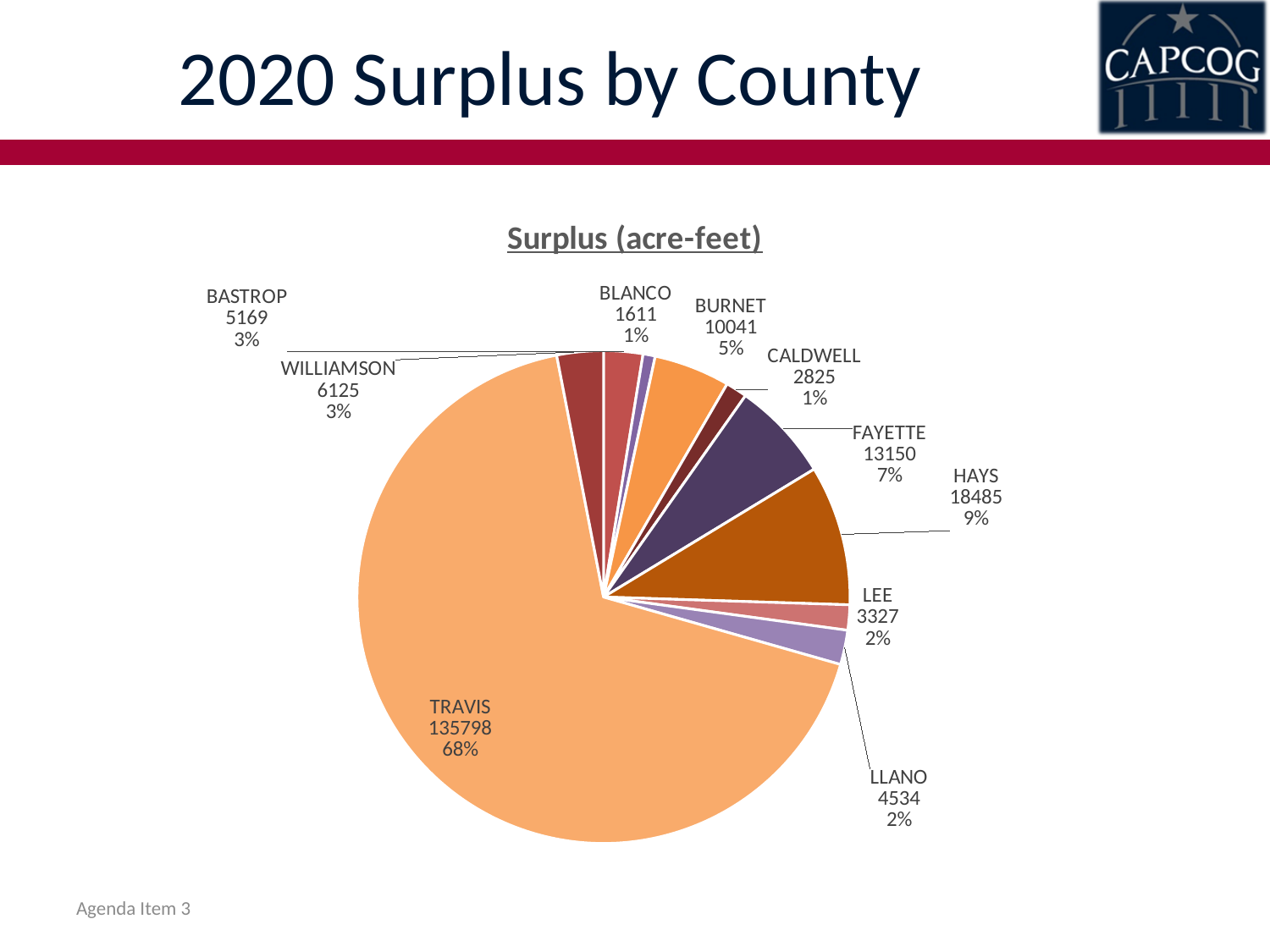
How many counties are shown in the pie chart? 10 What is the title of the chart? Surplus (acre-feet) What is the surplus value for Hays county? 18485 What kind of chart is shown on the slide? Pie chart What is the difference between the surplus for Hays and the surplus for Fayette? 5335 What is the surplus value for Burnet county? 10041 Which county has a larger surplus, Williamson or Bastrop? Williamson Which county has the smallest surplus? Blanco What share of the total surplus does Fayette county account for? 7% What share of the total surplus does Travis county account for? 68% Which county has the largest surplus? Travis What is the surplus value for Travis county? 135798